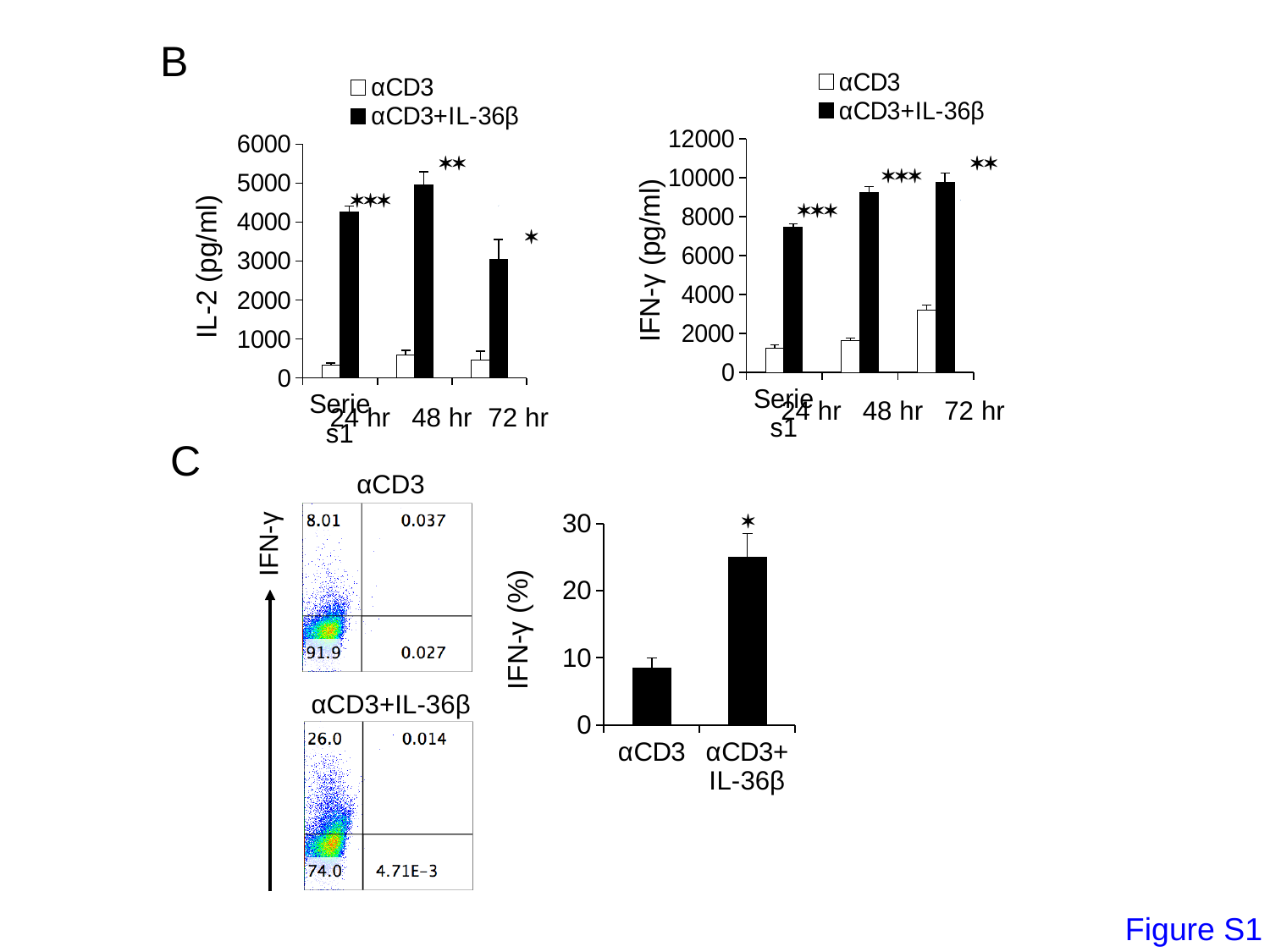
In the IL-2 (pg/ml) chart, is the αCD3 value at 48 hr greater or less than 1000? less In the IL-2 (pg/ml) chart, is the αCD3+IL-36β value at 24 hr greater or less than 4000? greater In the IFN-γ (%) chart, is the value for αCD3 greater or less than 10? less In the IFN-γ (pg/ml) chart, do the αCD3 values rise or fall from 24 hr to 72 hr? rise In the IL-2 (pg/ml) chart, which time point has the highest αCD3+IL-36β bar? 48 hr In the IL-2 (pg/ml) chart, which time point has the lowest αCD3+IL-36β bar? 72 hr What kind of chart is the IFN-γ (%) chart? bar chart In the IFN-γ (pg/ml) chart, which time point has the lowest αCD3+IL-36β bar? 24 hr How many series does the legend of the IL-2 (pg/ml) chart list? 2 In the IFN-γ (%) chart, which is larger, the αCD3 bar or the αCD3+IL-36β bar? αCD3+IL-36β